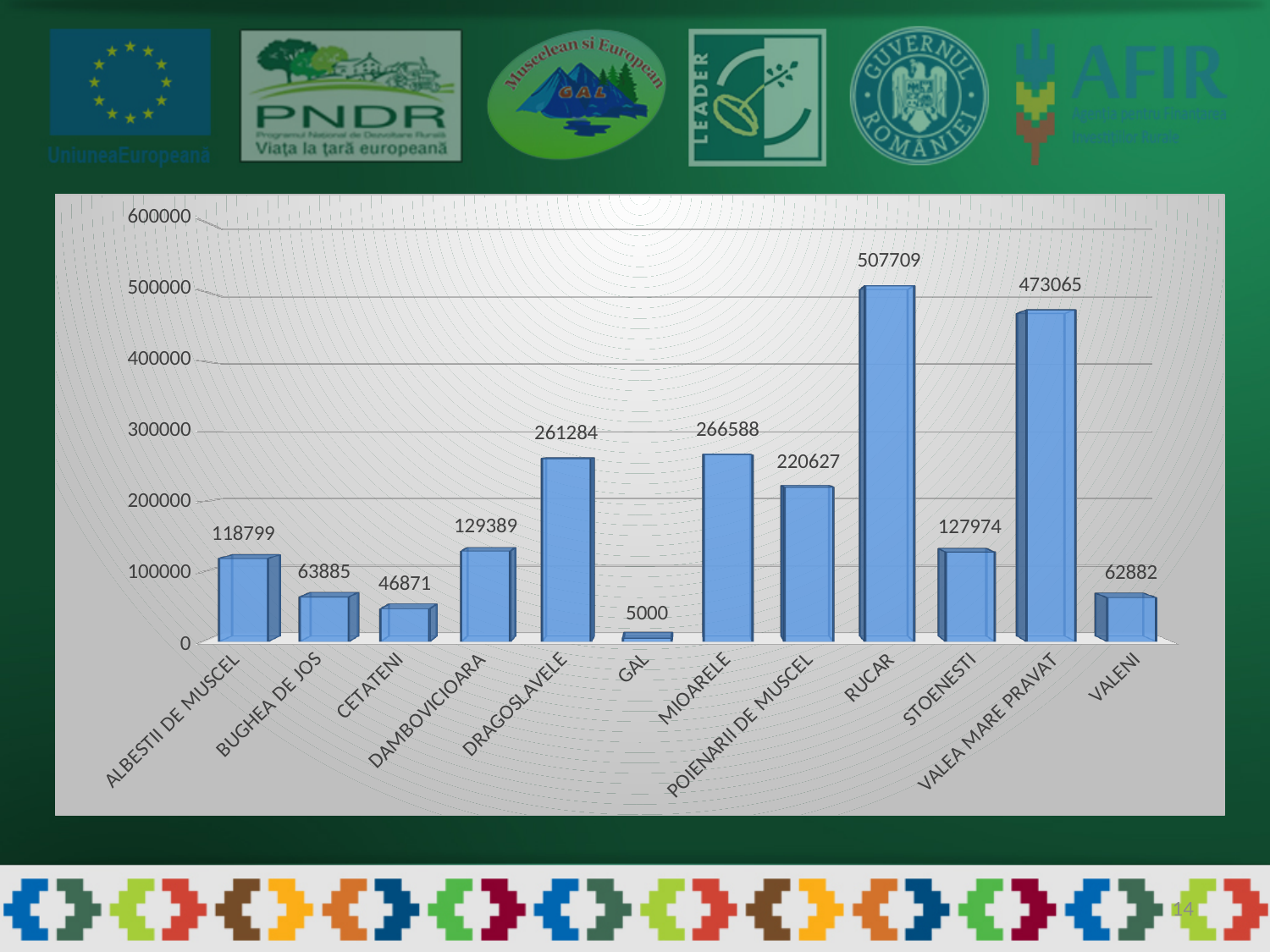
What is the difference between the values for RUCAR and VALEA MARE PRAVAT? 34644 What is the value for GAL? 5000 Which is larger, the value for DRAGOSLAVELE or the value for POIENARII DE MUSCEL? DRAGOSLAVELE What is the value for DRAGOSLAVELE? 261284 Which category has the lowest value? GAL What is the value for RUCAR? 507709 Which category has the highest value? RUCAR What is the difference between the values for ALBESTII DE MUSCEL and BUGHEA DE JOS? 54914 What kind of chart is shown on the slide? bar chart How many categories are shown on the x axis? 12 What is the value for POIENARII DE MUSCEL? 220627 Is the value for VALEA MARE PRAVAT greater or less than 400000? greater